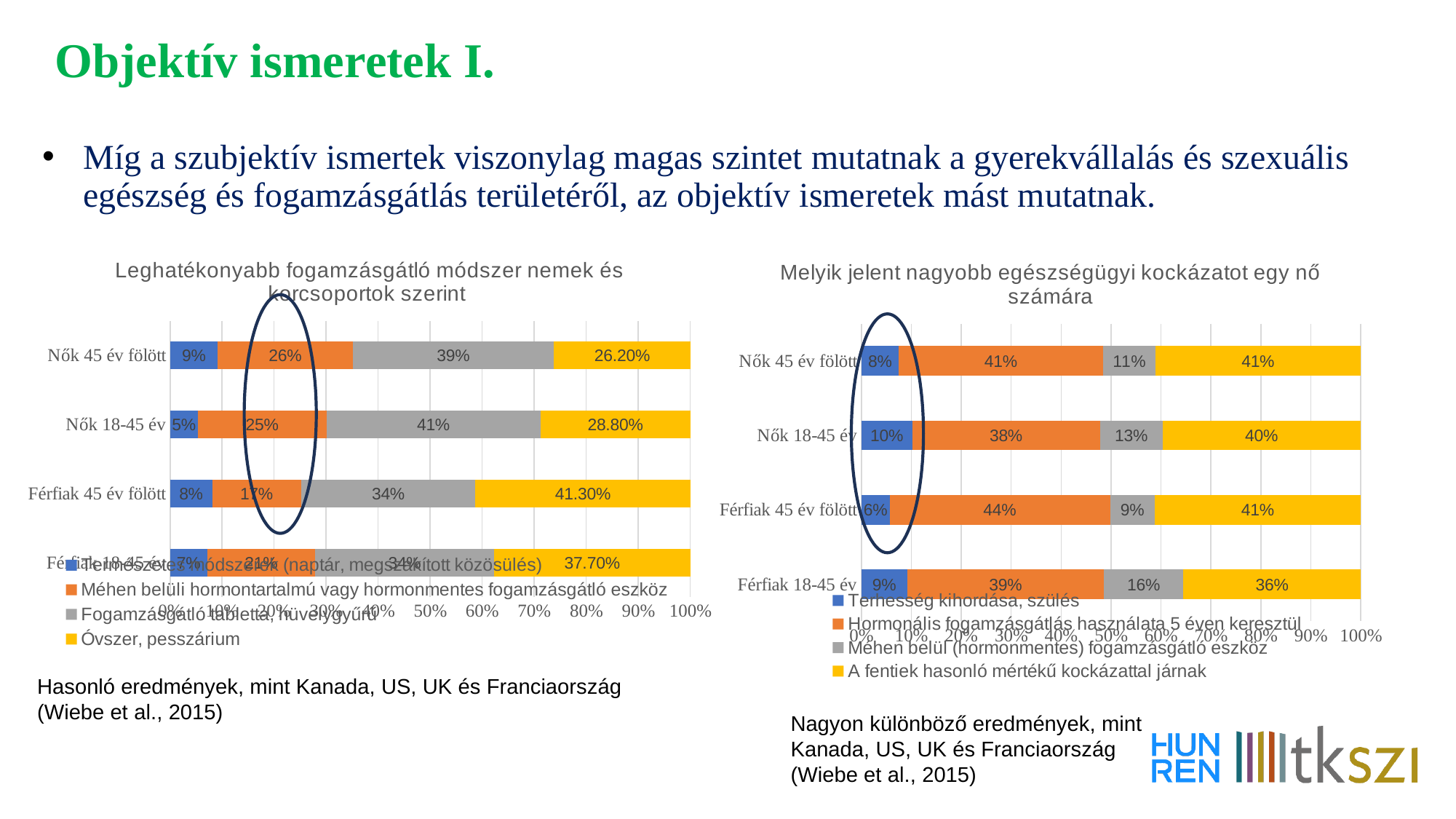
In the right chart (Melyik jelent nagyobb egészségügyi kockázatot egy nő számára), what is the value of the Méhen belül (hormonmentes) fogamzásgátló eszköz segment for Férfiak 18-45 év? 16% What kind of chart is the right chart (Melyik jelent nagyobb egészségügyi kockázatot egy nő számára)? Stacked bar chart In the left chart (Leghatékonyabb fogamzásgátló módszer nemek és korcsoportok szerint), which category has the lowest value for Természetes módszerek? Nők 18-45 év In the left chart (Leghatékonyabb fogamzásgátló módszer nemek és korcsoportok szerint), which category has the highest value for Óvszer, pesszárium? Férfiak 45 év fölött In the right chart (Melyik jelent nagyobb egészségügyi kockázatot egy nő számára), which category has the highest value for Terhesség kihordása, szülés? Nők 18-45 év How many categories are shown on the left chart (Leghatékonyabb fogamzásgátló módszer nemek és korcsoportok szerint)? 4 In the left chart (Leghatékonyabb fogamzásgátló módszer nemek és korcsoportok szerint), what is the value of the Óvszer, pesszárium segment for Férfiak 45 év fölött? 41.30% In the left chart (Leghatékonyabb fogamzásgátló módszer nemek és korcsoportok szerint), what is the value of the Fogamzásgátló tabletta, hüvelygyűrű segment for Nők 18-45 év? 41% In the right chart (Melyik jelent nagyobb egészségügyi kockázatot egy nő számára), is the Hormonális fogamzásgátlás value for Nők 18-45 év larger or smaller than the same value for Férfiak 45 év fölött? smaller In the right chart (Melyik jelent nagyobb egészségügyi kockázatot egy nő számára), what is the value of the Hormonális fogamzásgátlás használata 5 éven keresztül segment for Férfiak 45 év fölött? 44% How many series does the legend of the right chart (Melyik jelent nagyobb egészségügyi kockázatot egy nő számára) list? 4 In the left chart (Leghatékonyabb fogamzásgátló módszer nemek és korcsoportok szerint), what is the difference between the Méhen belüli eszköz values for Nők 45 év fölött and Férfiak 45 év fölött? 9%